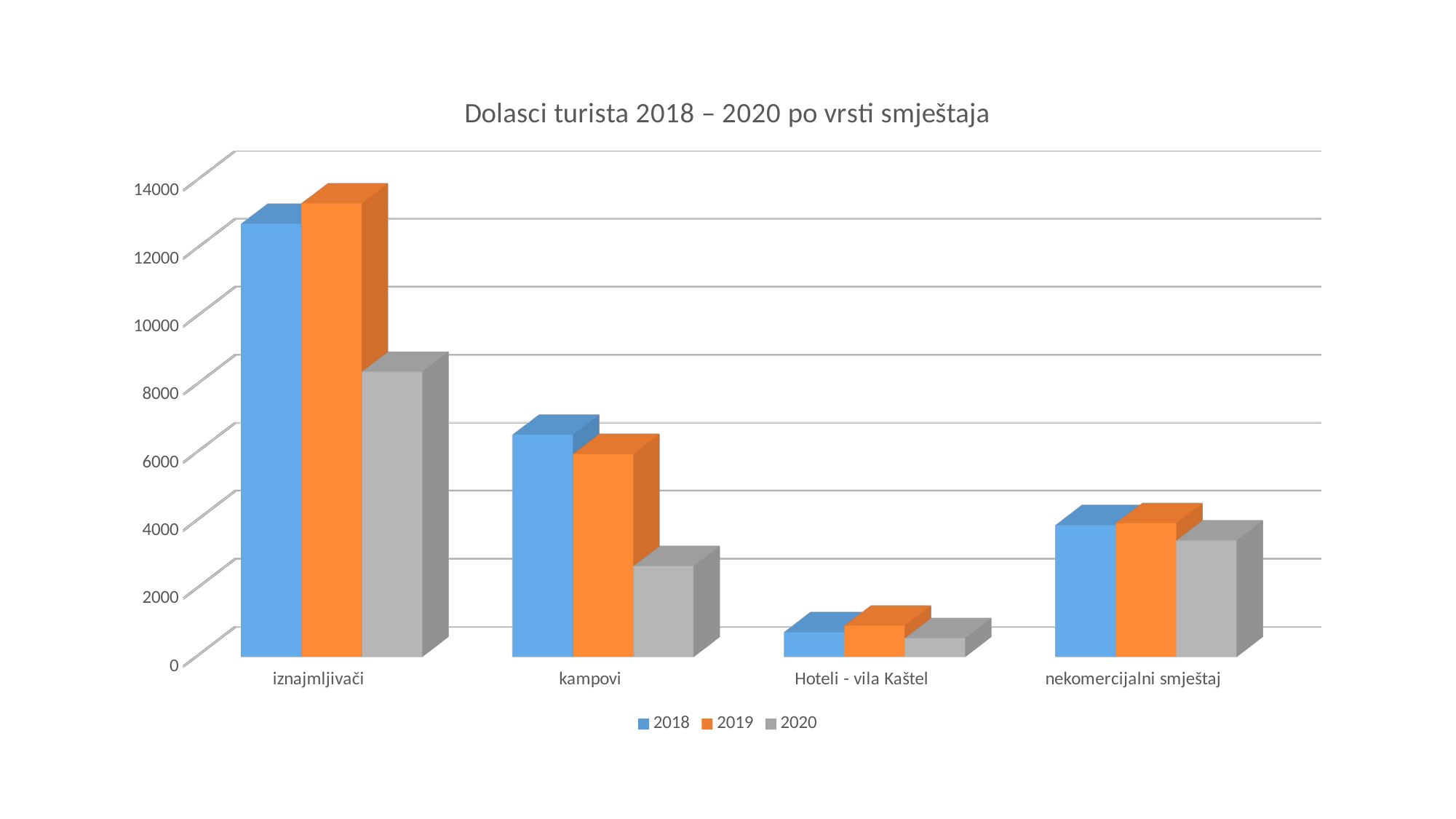
For kampovi, which is larger: the 2018 value or the 2020 value? 2018 How many series does the legend list? 3 Is the 2019 value for Hoteli - vila Kaštel greater or less than 2000? less Is the 2018 value for nekomercijalni smještaj greater or less than 6000? less Which category has the highest bars overall? iznajmljivači What kind of chart is shown on the slide? bar chart Which colour represents the 2019 series in the legend? orange Which category has the lowest bars overall? Hoteli - vila Kaštel How many accommodation categories are shown on the x axis? 4 Is the 2020 value for kampovi greater or less than 4000? less What is the title of the chart? Dolasci turista 2018 – 2020 po vrsti smještaja